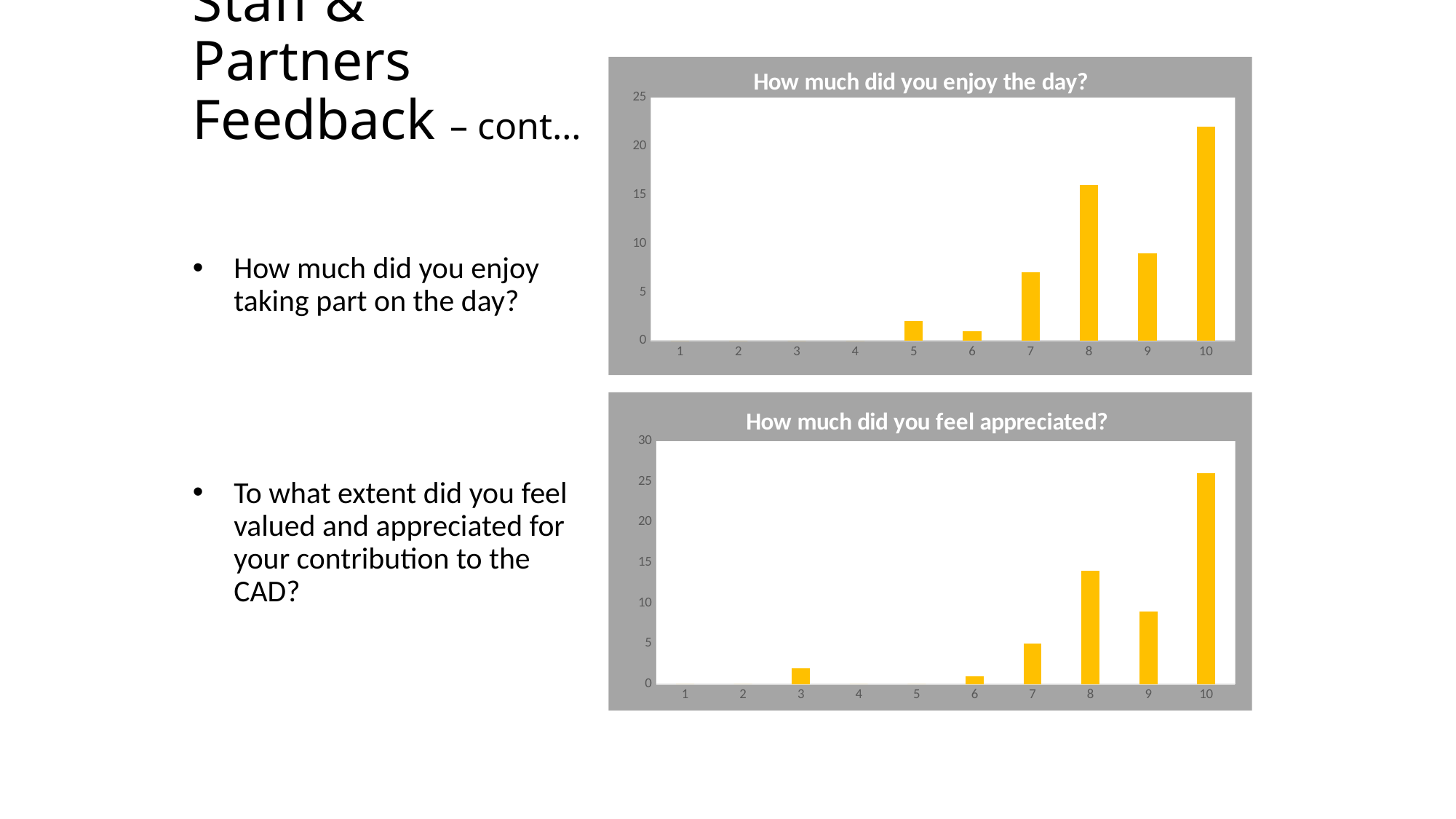
In the top chart "How much did you enjoy the day?", which has the larger value, 8 or 9? 8 How many categories are shown on the x axis of the top chart "How much did you enjoy the day?"? 10 What kind of chart is the top chart titled "How much did you enjoy the day?"? bar chart In the top chart "How much did you enjoy the day?", is the value for 7 greater or less than 10? less In the bottom chart "How much did you feel appreciated?", which category has the highest value? 10 In the bottom chart "How much did you feel appreciated?", which has the larger value, 7 or 9? 9 In the bottom chart "How much did you feel appreciated?", is the value for 3 greater or less than 5? less In the top chart "How much did you enjoy the day?", is the value for 8 greater or less than 15? greater In the top chart "How much did you enjoy the day?", which category has the highest value? 10 What is the title of the bottom chart on the slide? How much did you feel appreciated?